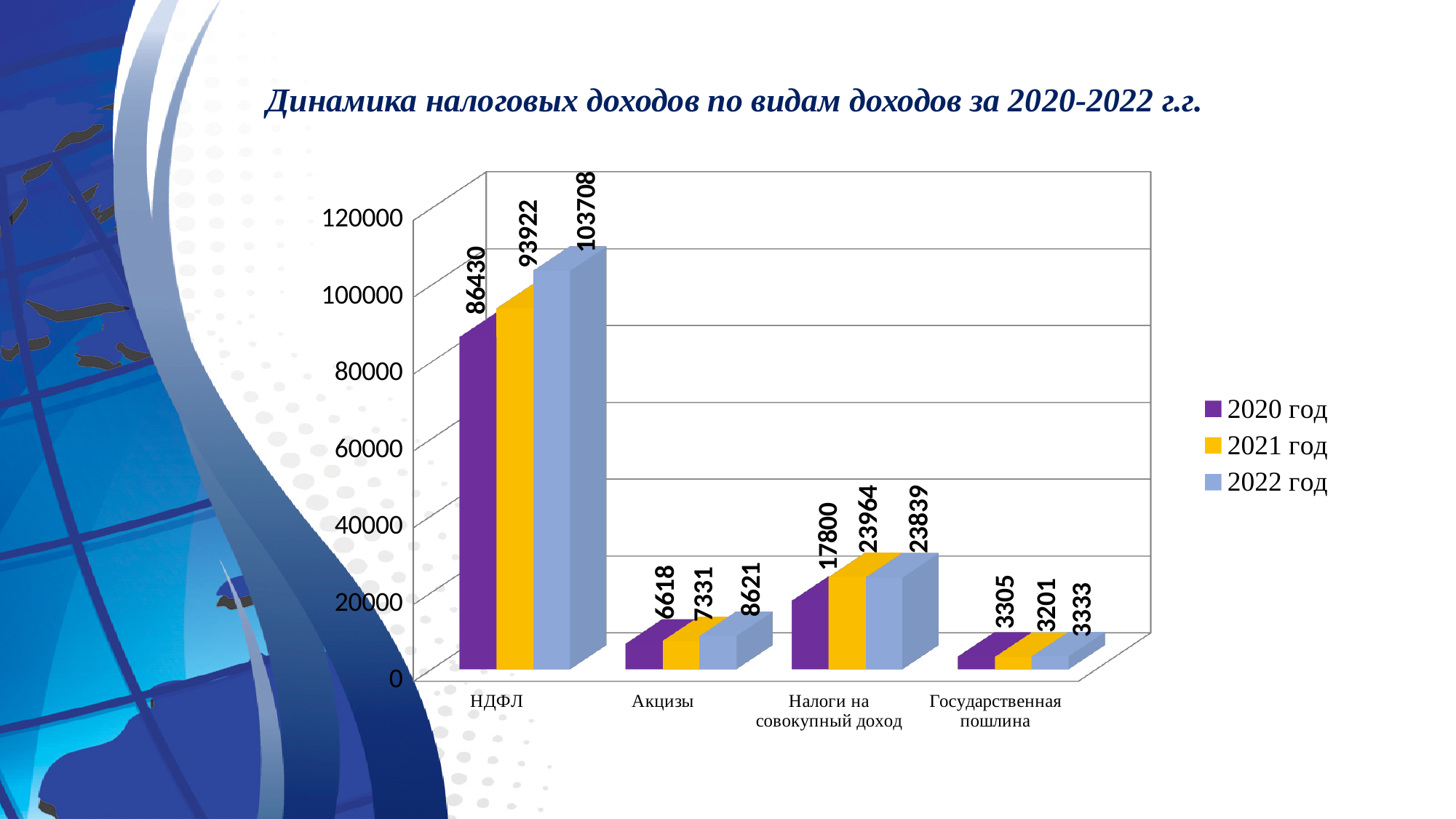
Is the value for НДФЛ in 2021 год greater or less than 100000? less Which is larger for Акцизы: the 2021 год value or the 2022 год value? 2022 год What is the difference between the 2022 год and 2020 год values for НДФЛ? 17278 What kind of chart is shown on the slide? bar chart What is the value for Государственная пошлина in the 2022 год series? 3333 What is the value for Налоги на совокупный доход in the 2021 год series? 23964 What is the value for НДФЛ in the 2022 год series? 103708 Which category has the highest value in the 2020 год series? НДФЛ How many categories are shown on the x axis? 4 Which category has the lowest value in the 2021 год series? Государственная пошлина What is the value for Акцизы in the 2020 год series? 6618 How many series does the legend list? 3